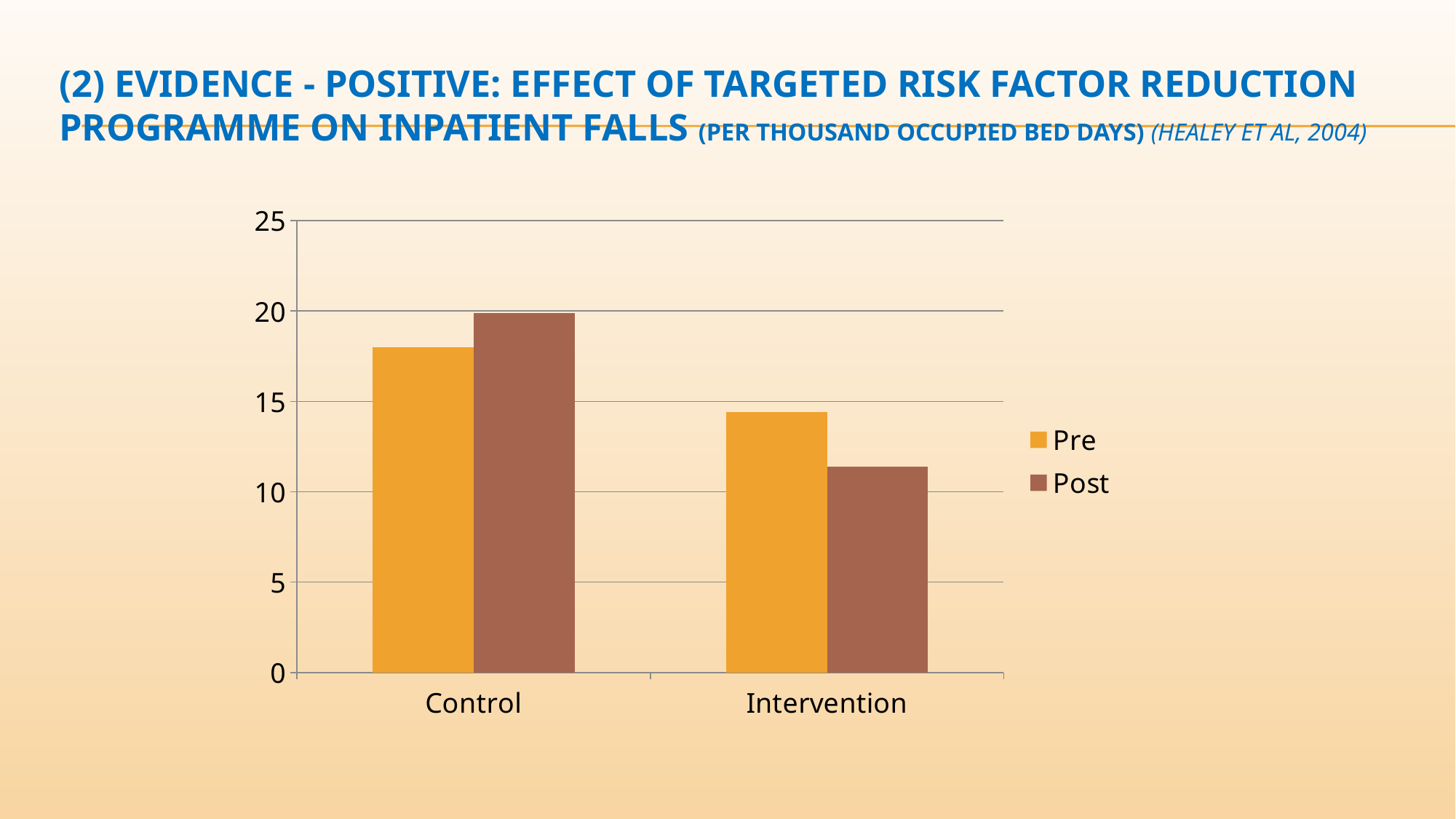
What kind of chart is shown on the slide? Bar chart For the Control group, which is larger, the Pre value or the Post value? Post Which bar is the shortest in the chart? Intervention, Post For the Intervention group, which is larger, the Pre value or the Post value? Pre What are the two legend entries of the chart? Pre and Post Which series is shown in brown in the chart? Post Is the Post value for Intervention greater or less than 10? greater How many categories are shown on the x axis of the chart? 2 Is the Pre value for Control greater or less than 15? greater How many series does the legend list? 2 Is the Post value for Intervention greater or less than 15? less Which bar is the tallest in the chart? Control, Post